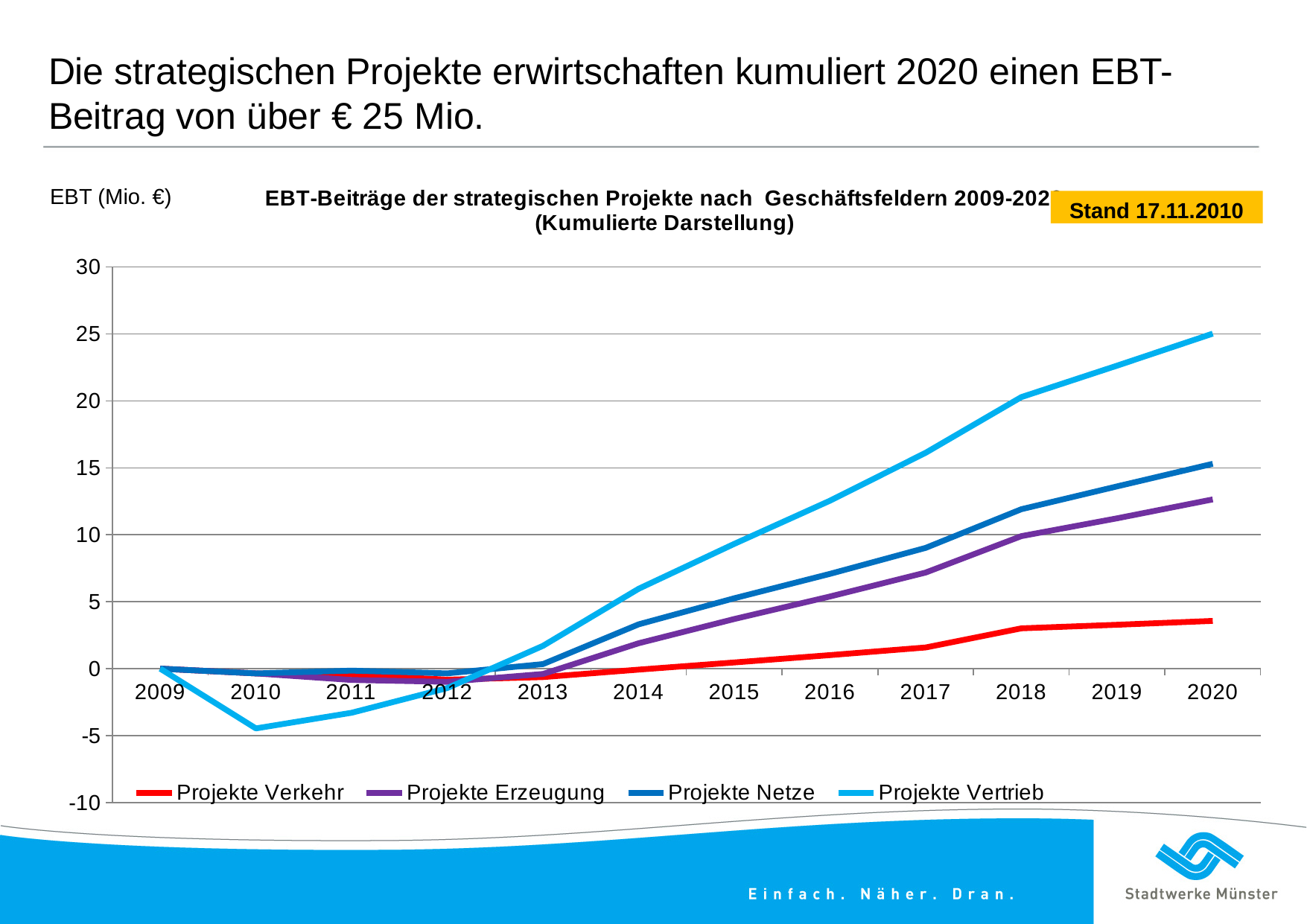
In 2018, which is larger: Projekte Netze or Projekte Erzeugung? Projekte Netze What kind of chart is shown on the slide? line chart How many years are shown on the x axis? 12 In which year does Projekte Vertrieb reach its lowest value? 2010 Does the Projekte Vertrieb line rise or fall from 2013 to 2020? rise Is the value for Projekte Netze in 2020 greater or less than 10? greater Which series has the highest value in 2020? Projekte Vertrieb Is the value for Projekte Erzeugung in 2020 greater or less than 15? less Which series has the lowest value in 2020? Projekte Verkehr Is the value for Projekte Vertrieb in 2020 greater or less than 20? greater How many series does the legend list? 4